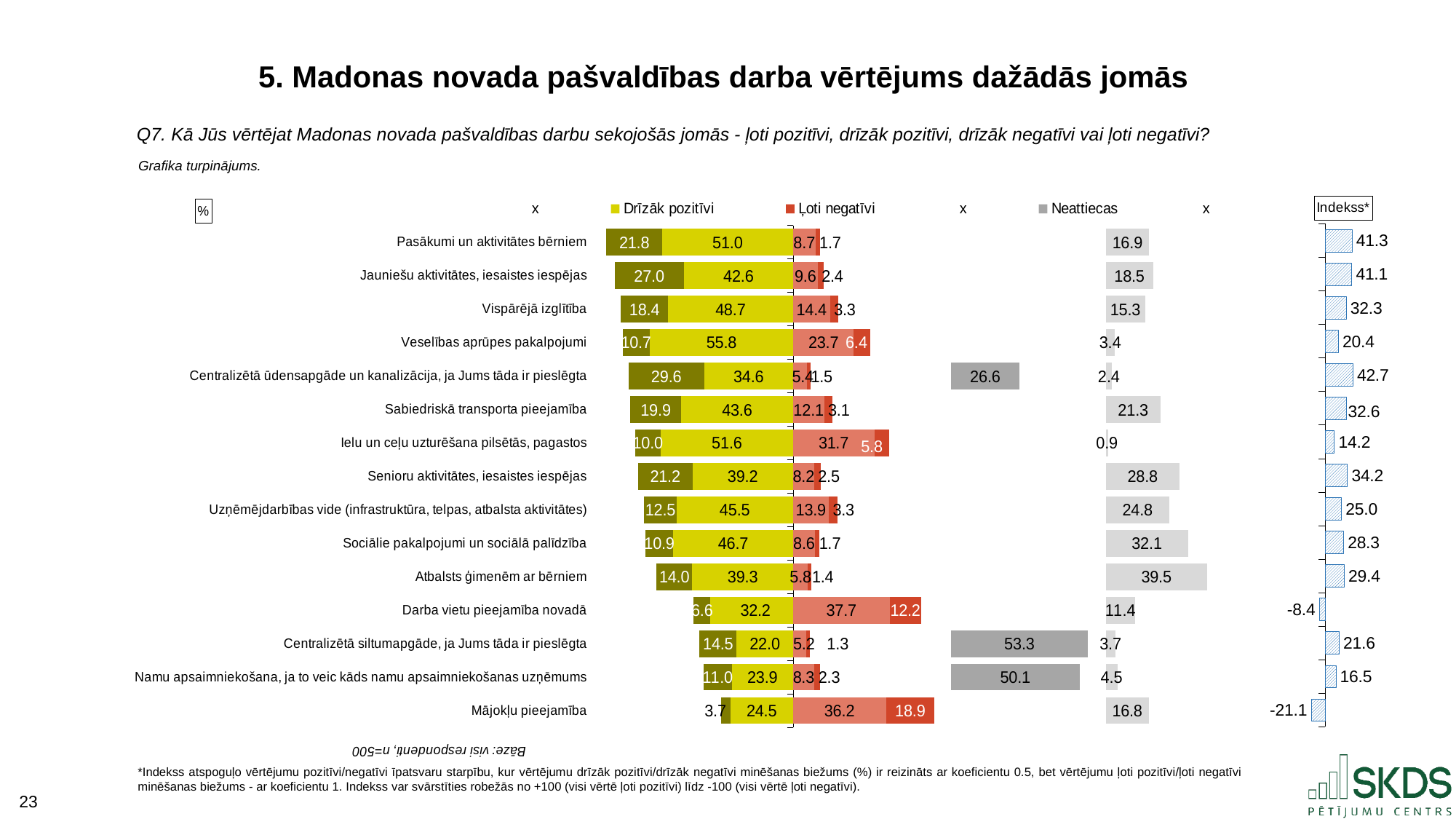
How many categories (rows) are shown in the chart? 15 Which category has the highest Indekss* value? Centralizētā ūdensapgāde un kanalizācija, ja Jums tāda ir pieslēgta What is the Indekss* value for 'Pasākumi un aktivitātes bērniem'? 41.3 Which category has the highest 'Drīzāk pozitīvi' value? Veselības aprūpes pakalpojumi What kind of chart is shown on the slide? Bar chart What is the 'Drīzāk pozitīvi' value for 'Veselības aprūpes pakalpojumi'? 55.8 What is the difference between the 'Drīzāk pozitīvi' values for 'Veselības aprūpes pakalpojumi' and 'Ielu un ceļu uzturēšana pilsētās, pagastos'? 4.2 Which has the larger 'Ļoti negatīvi' value: 'Mājokļu pieejamība' or 'Darba vietu pieejamība novadā'? Mājokļu pieejamība Which category has the lowest Indekss* value? Mājokļu pieejamība What is the 'Ļoti negatīvi' value for 'Ielu un ceļu uzturēšana pilsētās, pagastos'? 5.8 Which legend entry is shown in yellow? Drīzāk pozitīvi